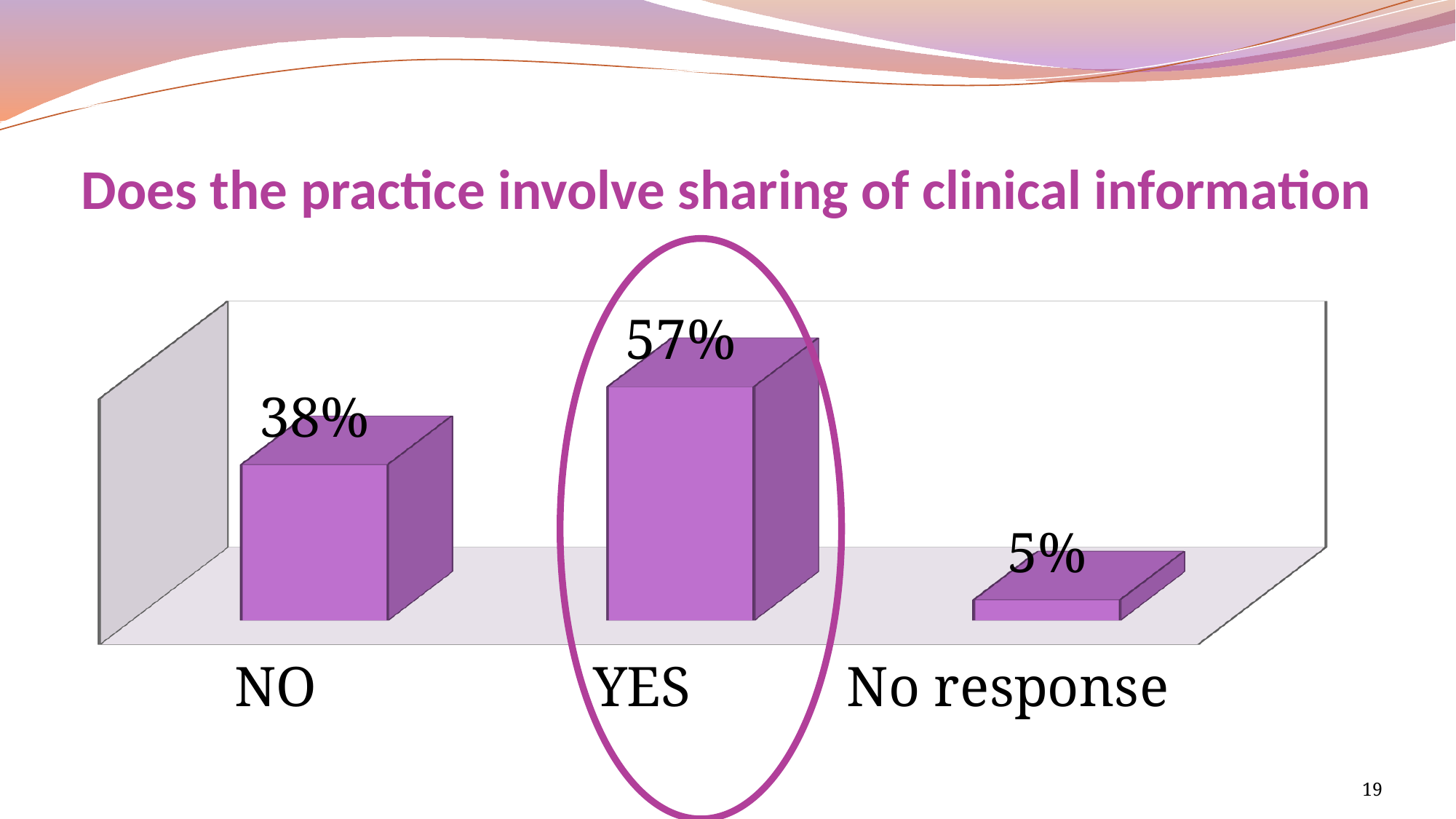
What is the difference between the values for NO and No response? 33% What is the value for YES? 57% Which is larger, the value for NO or the value for YES? YES Which category has the highest value? YES How many categories are shown in the chart? 3 What is the difference between the values for YES and NO? 19% What kind of chart is shown on the slide? Bar chart What is the value for No response? 5% What is the title of the slide above the chart? Does the practice involve sharing of clinical information Which category has the lowest value? No response Which category's bar is circled on the slide? YES What is the value for NO? 38%